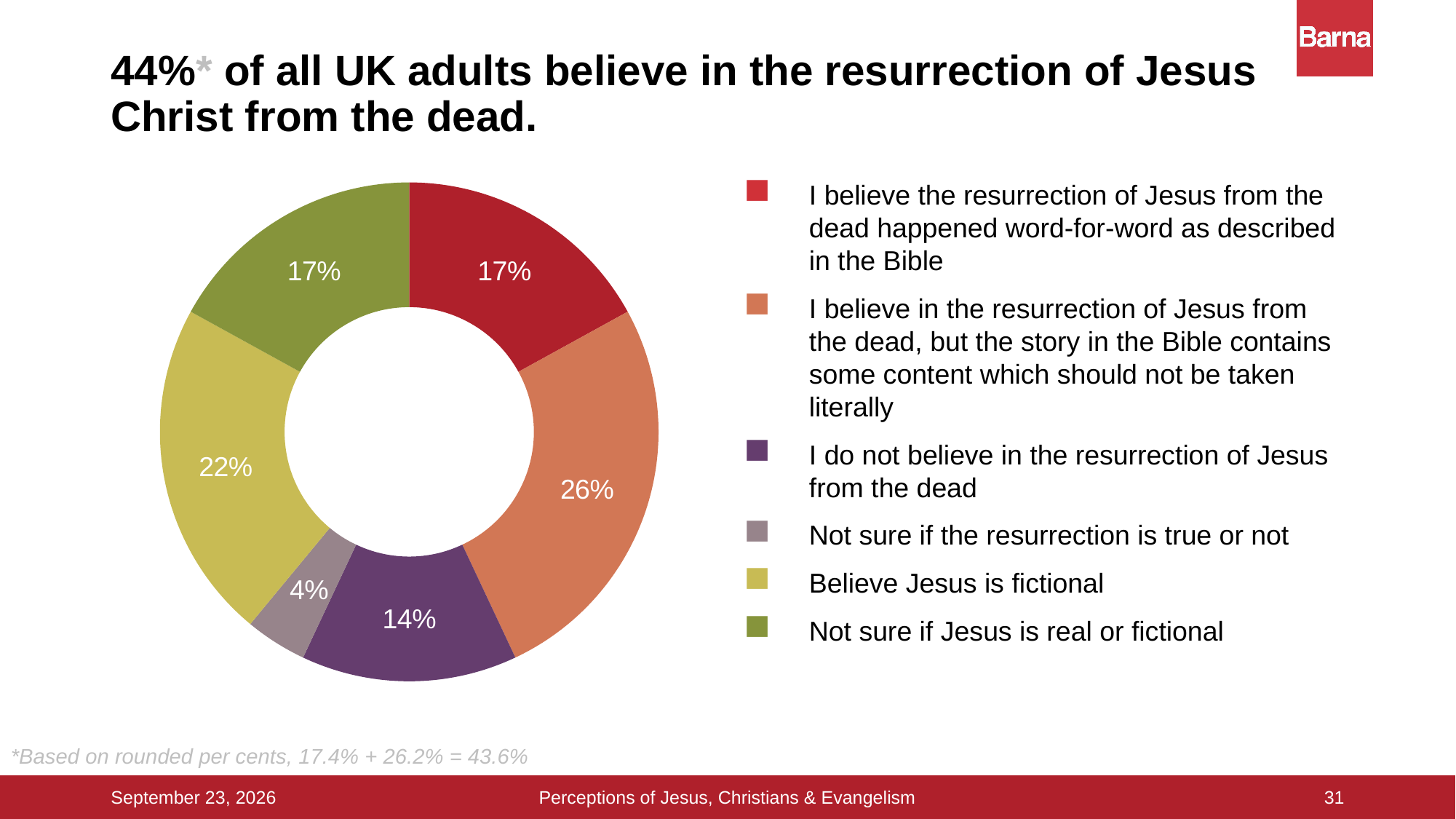
What percentage are not sure if the resurrection is true or not? 4% What kind of chart is shown on the slide? Doughnut (pie) chart What percentage do not believe in the resurrection of Jesus from the dead? 14% Which response has the smallest share of the chart? Not sure if the resurrection is true or not How many response categories does the chart show? 6 Which response has the largest share of the chart? I believe in the resurrection of Jesus from the dead, but the story in the Bible contains some content which should not be taken literally What colour is the slice for 'I do not believe in the resurrection of Jesus from the dead'? Purple What percentage believe Jesus is fictional? 22% Which is larger: the share who believe Jesus is fictional or the share who are not sure if Jesus is real or fictional? Believe Jesus is fictional What is the difference between the share who believe Jesus is fictional and the share who do not believe in the resurrection? 8% What percentage believe in the resurrection but think the Bible story contains some content which should not be taken literally? 26% What percentage of UK adults believe the resurrection of Jesus from the dead happened word-for-word as described in the Bible? 17%